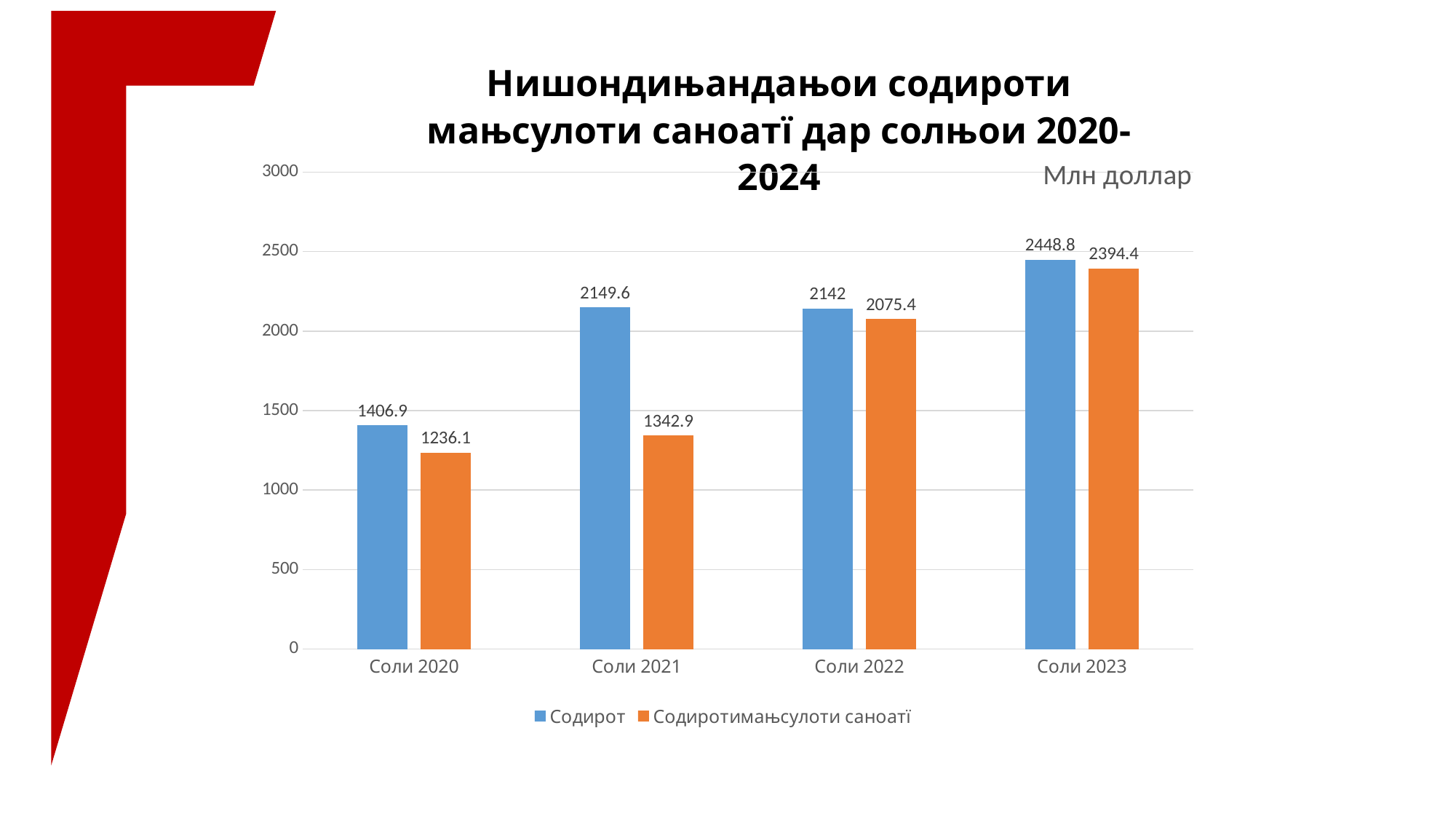
Which is larger in Соли 2021: Содирот or Содиротимаҳсулоти саноатӣ? Содирот What is the value for Содиротимаҳсулоти саноатӣ in Соли 2023? 2394.4 What is the value for Содиротимаҳсулоти саноатӣ in Соли 2020? 1236.1 Does the Содиротимаҳсулоти саноатӣ series rise or fall from Соли 2020 to Соли 2023? rise By how much did Содирот increase from Соли 2020 to Соли 2023? 1041.9 How many years are shown on the x axis? 4 What is the value for Содирот in Соли 2021? 2149.6 What is the value for Содирот in Соли 2022? 2142 Is the value for Содиротимаҳсулоти саноатӣ in Соли 2022 greater or less than 2000? greater What is the difference between Содирот and Содиротимаҳсулоти саноатӣ in Соли 2020? 170.8 In which year is the Содирот value highest? Соли 2023 In which year is the Содиротимаҳсулоти саноатӣ value lowest? Соли 2020